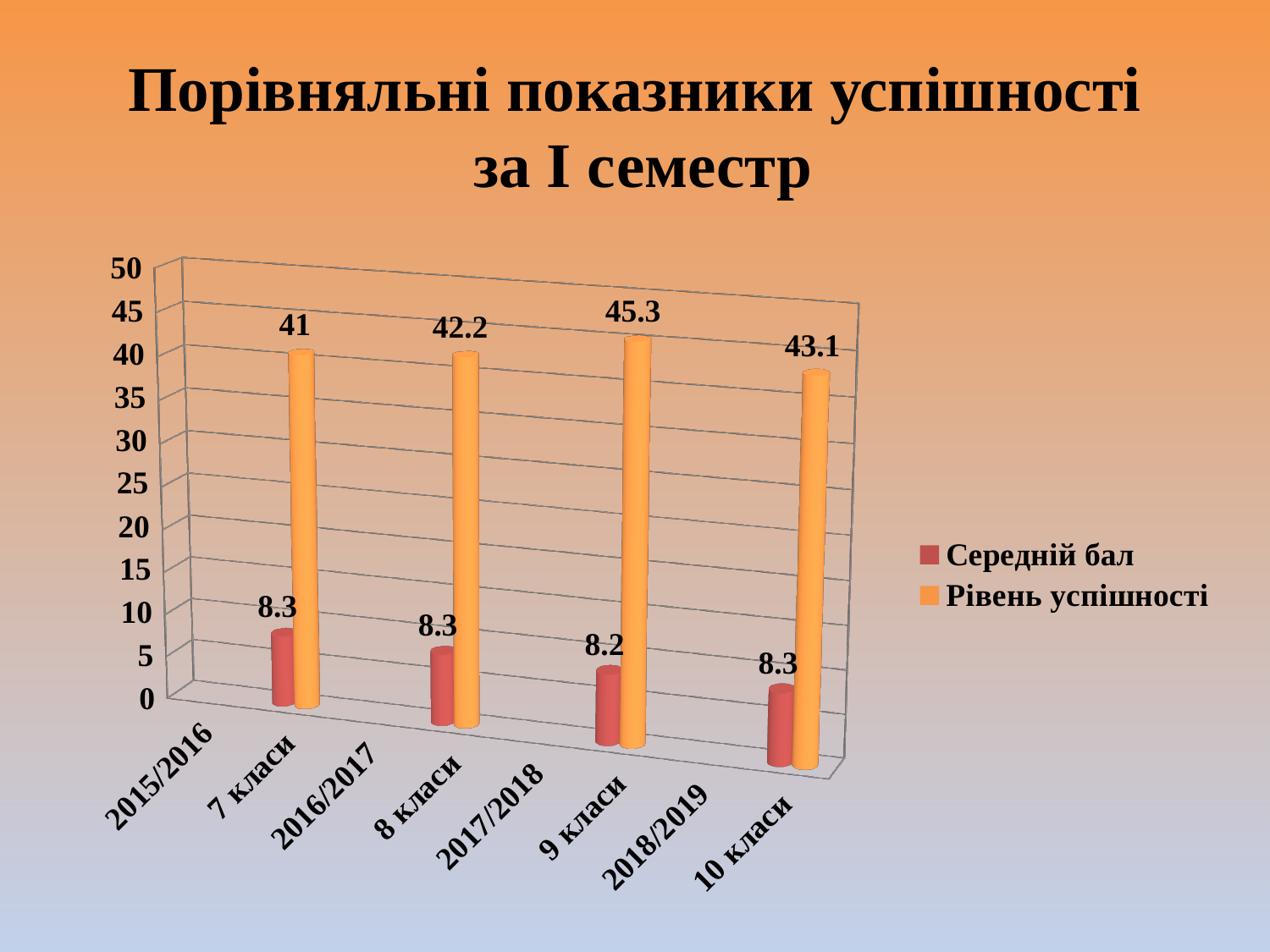
Which category has the lowest Рівень успішності? 2015/2016 7 класи What is the value of Рівень успішності for 2015/2016 7 класи? 41 Which category has the highest Рівень успішності? 2017/2018 9 класи What is the value of Рівень успішності for 2017/2018 9 класи? 45.3 What is the difference in Рівень успішності between 2017/2018 9 класи and 2015/2016 7 класи? 4.3 How many categories are shown on the x axis? 8 What kind of chart is shown on the slide? Bar chart How many series does the legend list? 2 What is the value of Рівень успішності for 2018/2019 10 класи? 43.1 Which is larger: Рівень успішності for 2016/2017 8 класи or for 2018/2019 10 класи? 2018/2019 10 класи What is the title of the chart on the slide? Порівняльні показники успішності за І семестр What is the value of Середній бал for 2017/2018 9 класи? 8.2